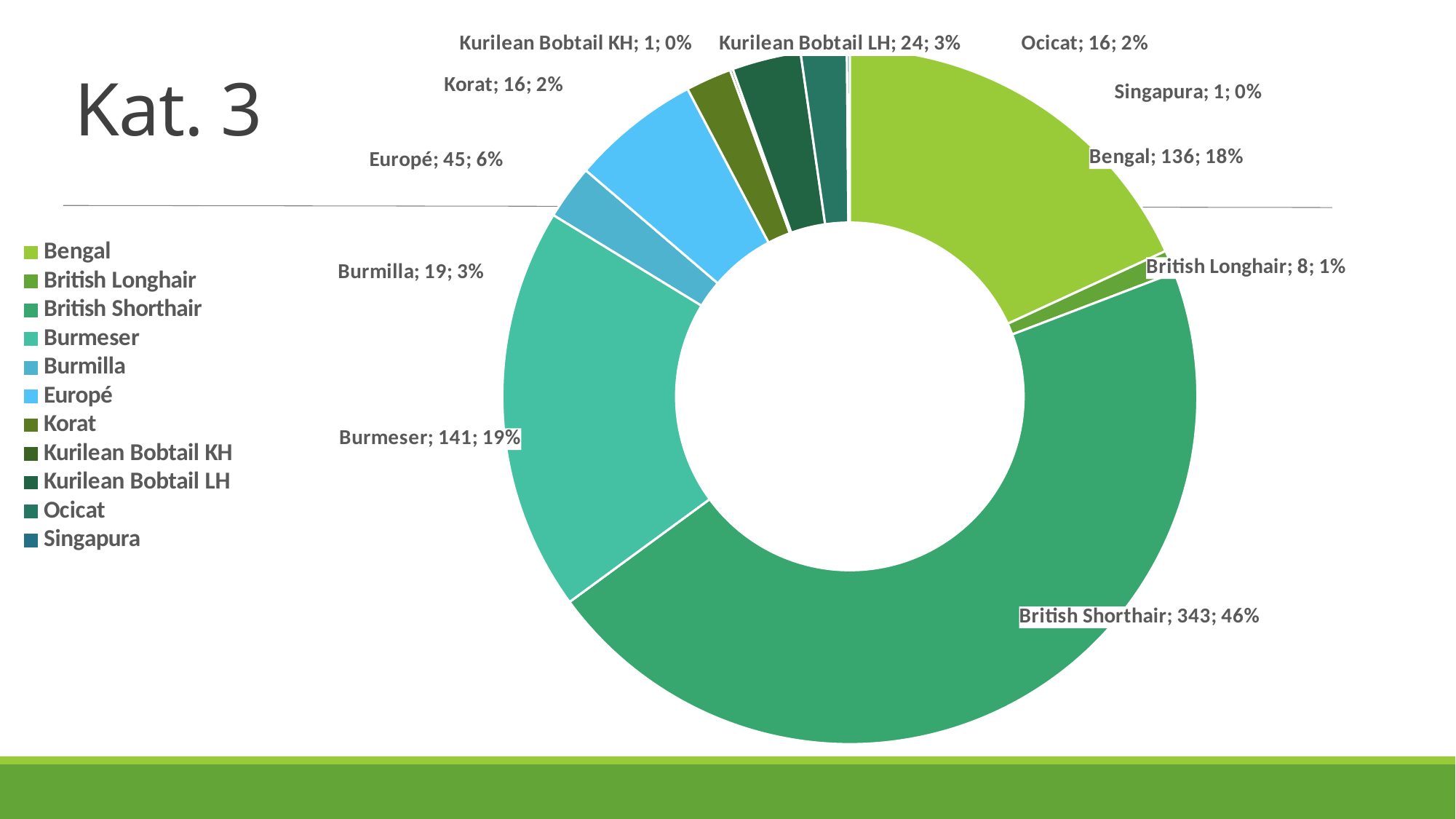
What is the value for Europé? 45 What is the value for British Shorthair? 343 How many categories does the legend list? 11 What share of the chart does Bengal represent? 18% What kind of chart is shown on the slide? doughnut chart What is the value for Burmeser? 141 What share of the chart does British Shorthair represent? 46% Which is larger, the value for Burmilla or the value for Korat? Burmilla What is the title of the slide containing the chart? Kat. 3 What is the value for Kurilean Bobtail LH? 24 What is the difference between the values for Burmeser and Bengal? 5 Which category has the highest value? British Shorthair